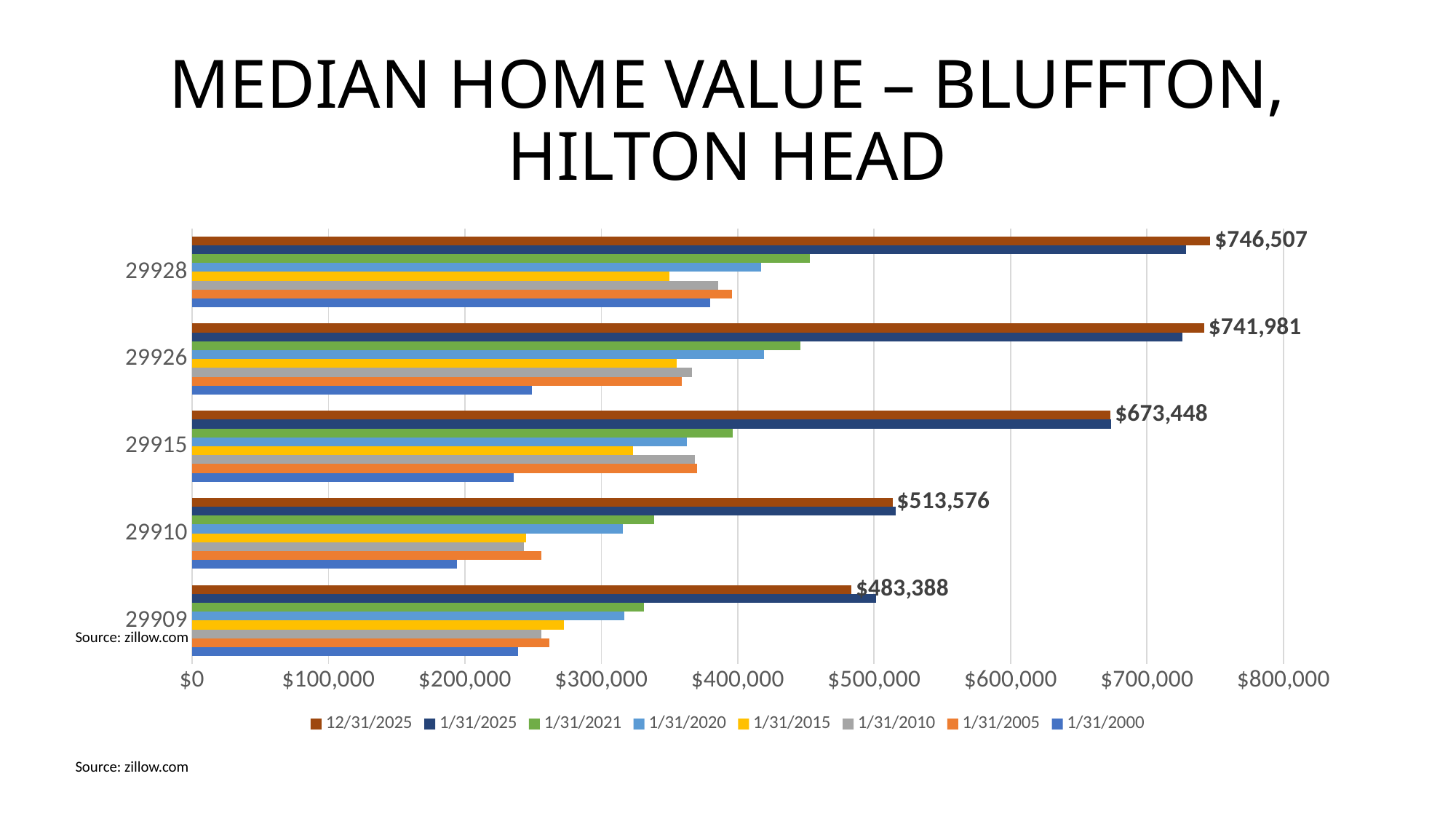
Which zip code has the larger 12/31/2025 median home value, 29915 or 29910? 29915 Is the 1/31/2000 median home value for zip code 29926 greater or less than $300,000? less How many zip codes are shown on the chart? 5 How many date series does the legend list? 8 What is the difference between the 12/31/2025 median home values of zip codes 29928 and 29909? $263,119 What is the median home value for zip code 29928 on 12/31/2025? $746,507 What is the median home value for zip code 29909 on 12/31/2025? $483,388 Which zip code has the lowest median home value on 12/31/2025? 29909 What is the difference between the 12/31/2025 median home values of zip codes 29926 and 29915? $68,533 Is the 1/31/2021 median home value for zip code 29928 greater or less than $400,000? greater What is the median home value for zip code 29915 on 12/31/2025? $673,448 Which zip code has the highest median home value on 12/31/2025? 29928